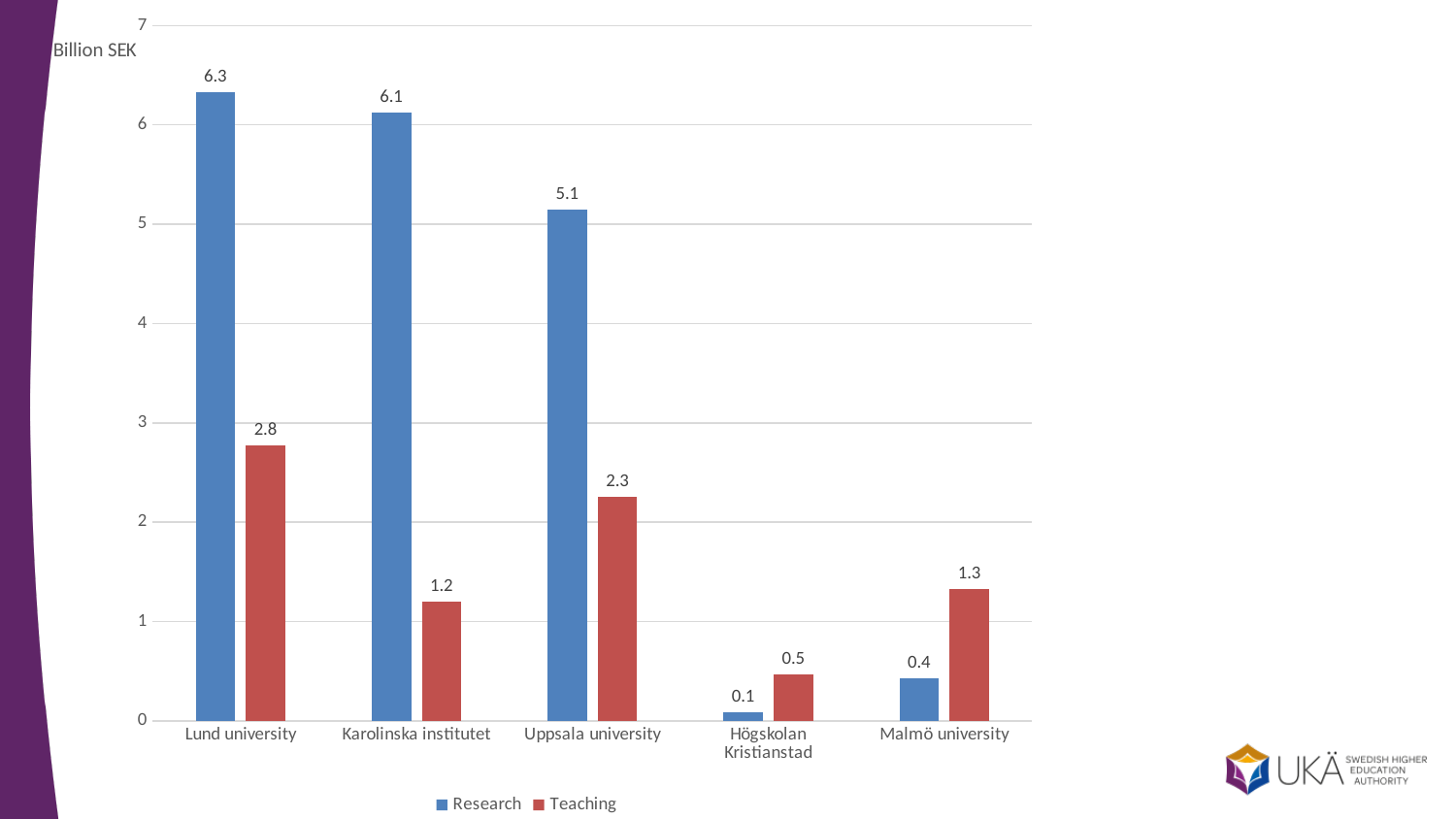
Which is larger for Malmö university, Research or Teaching? Teaching What is the difference between the Research and Teaching values for Uppsala university? 2.8 Which university has the highest Research value? Lund university What is the Research value for Högskolan Kristianstad? 0.1 How many series does the legend list? 2 Which university has the lowest Teaching value? Högskolan Kristianstad What is the Teaching value for Karolinska institutet? 1.2 Is the Research value for Uppsala university greater or less than 5? greater What kind of chart is shown on the slide? Bar chart How many universities are shown on the x axis? 5 What is the Research value for Lund university? 6.3 What unit is shown on the y axis label? Billion SEK